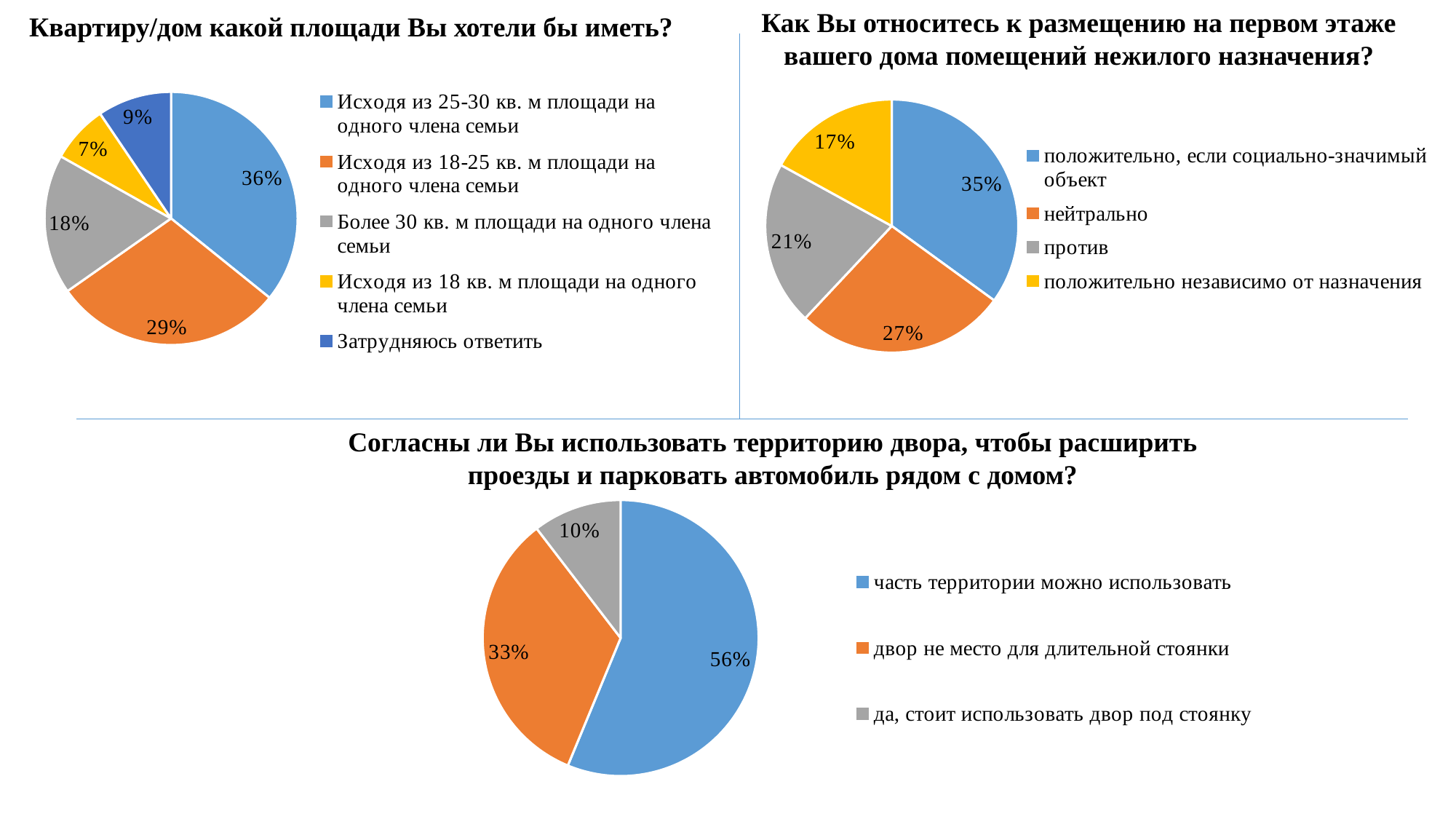
In the top-left chart "Квартиру/дом какой площади Вы хотели бы иметь?", what share is shown for "Исходя из 25-30 кв. м площади на одного члена семьи"? 36% In the bottom chart about using the yard territory for parking, how many entries does the legend list? 3 In the top-left chart "Квартиру/дом какой площади Вы хотели бы иметь?", which category has the smallest slice? Исходя из 18 кв. м площади на одного члена семьи What type of chart is used in the bottom chart about using the yard territory for parking? Pie chart In the top-right chart about non-residential premises on the first floor, what share answered "нейтрально"? 27% In the top-left chart "Квартиру/дом какой площади Вы хотели бы иметь?", how many slices does the pie have? 5 In the bottom chart about using the yard territory for parking, what share answered "двор не место для длительной стоянки"? 33% In the top-right chart about non-residential premises on the first floor, what is the combined share of "положительно, если социально-значимый объект" and "положительно независимо от назначения"? 52% In the bottom chart about using the yard territory for parking, which answer has the smallest share? да, стоит использовать двор под стоянку In the top-left chart "Квартиру/дом какой площади Вы хотели бы иметь?", what is the difference between the shares for "Исходя из 18-25 кв. м" and "Более 30 кв. м"? 11% In the top-right chart about non-residential premises on the first floor, which is larger: "против" or "положительно независимо от назначения"? против In the top-right chart about non-residential premises on the first floor, which answer has the largest share? положительно, если социально-значимый объект